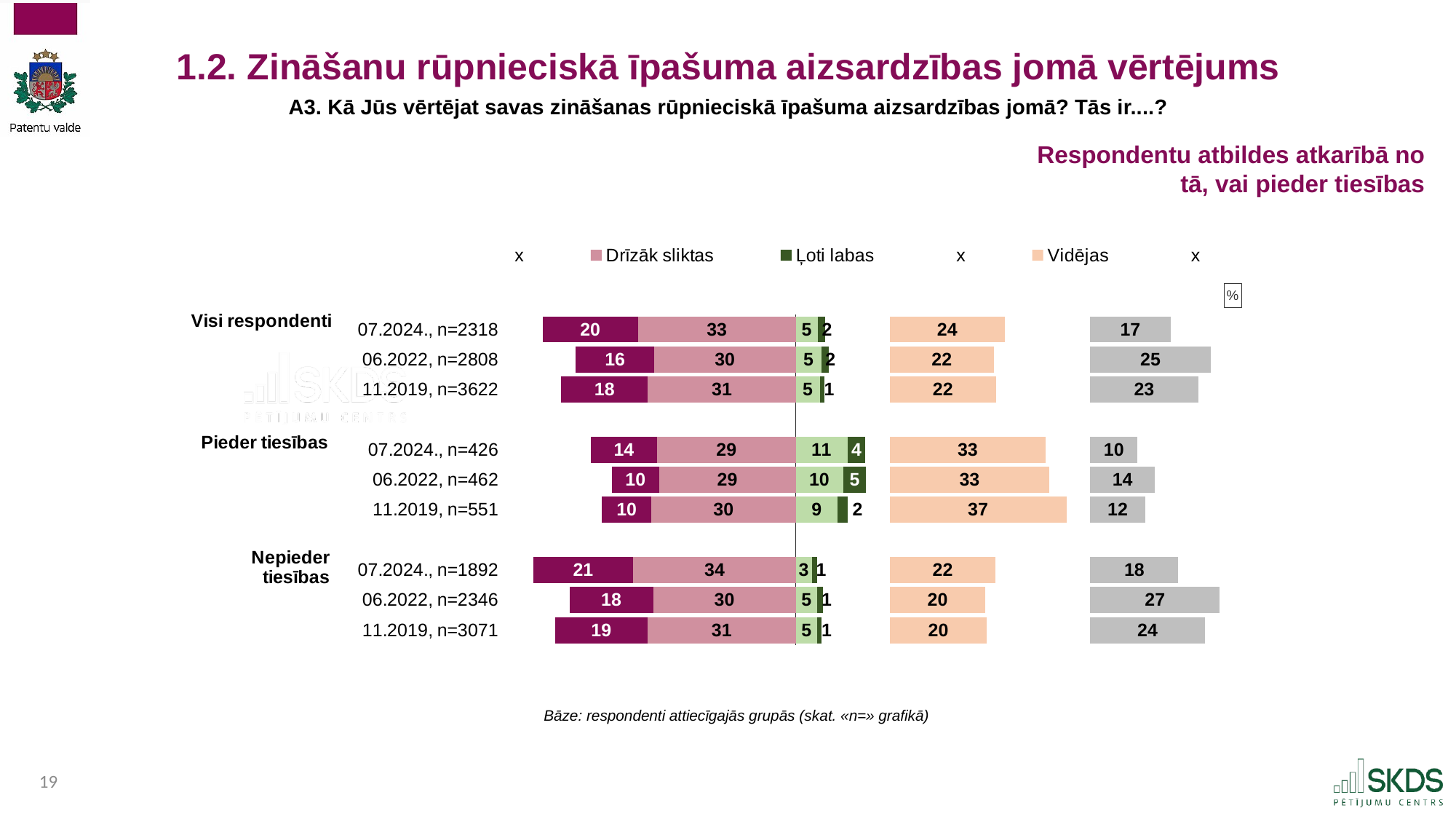
What is the value of "Ļoti labas" for Pieder tiesības, 06.2022? 5 How many bar rows (survey waves across all groups) are shown in the chart? 9 What is the value of "Drīzāk sliktas" for Visi respondenti, 07.2024? 33 What is the value of "Vidējas" for Pieder tiesības, 11.2019? 37 What is the value of "Ļoti labas" for Nepieder tiesības, 07.2024? 1 What kind of chart is shown on the slide? Stacked horizontal bar chart Which row has the highest "Drīzāk sliktas" value? Nepieder tiesības, 07.2024 What colour represents "Vidējas" in the chart? Peach (light orange) What is the difference between the "Vidējas" value for Pieder tiesības 07.2024 and for Visi respondenti 07.2024? 9 Did the "Vidējas" value for Nepieder tiesības rise or fall from 11.2019 to 07.2024? Rise Which row has the highest "Vidējas" value? Pieder tiesības, 11.2019 Which is larger for 07.2024: the "Drīzāk sliktas" value for Visi respondenti or for Pieder tiesības? Visi respondenti